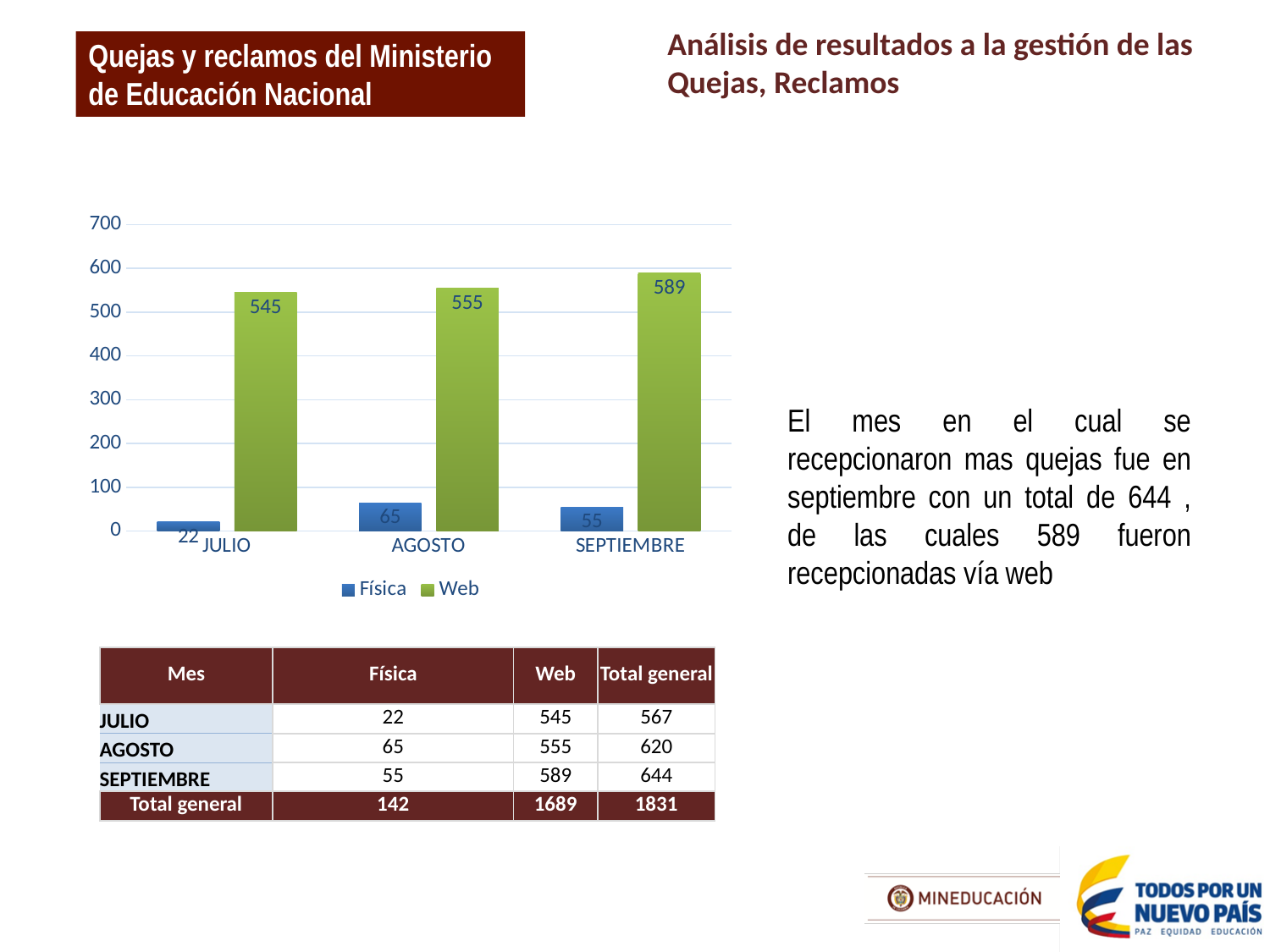
What is the Física value for JULIO? 22 What is the Web value for SEPTIEMBRE? 589 What kind of chart is shown on the slide? bar chart How many months are shown on the x axis of the chart? 3 Is the Web value for AGOSTO greater or less than 500? greater Which month has the highest Web value? SEPTIEMBRE How many series does the chart legend list? 2 What is the difference between the Web values for SEPTIEMBRE and JULIO? 44 Do the Web values rise or fall from JULIO to SEPTIEMBRE? rise Which month has the lowest Física value? JULIO What is the Física value for AGOSTO? 65 Which is larger, the Física value for AGOSTO or the Física value for SEPTIEMBRE? AGOSTO